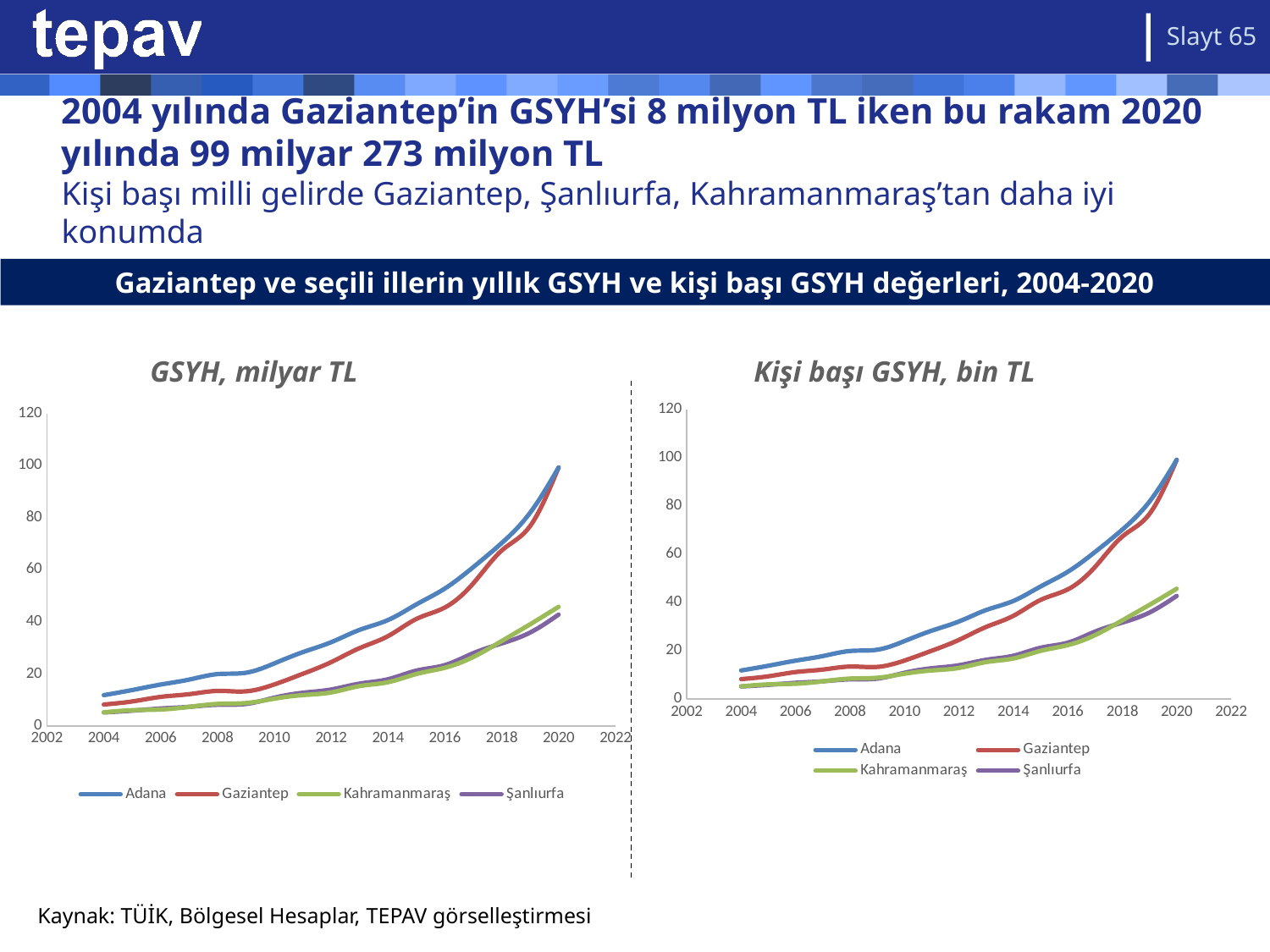
What is the title of the right chart on the slide? Kişi başı GSYH, bin TL How many series does the legend of the right chart 'Kişi başı GSYH, bin TL' list? 4 In the left chart 'GSYH, milyar TL', is the value for Adana in 2004 greater or less than 20? less In the right chart 'Kişi başı GSYH, bin TL', does the Kahramanmaraş line rise or fall from 2004 to 2020? rise In the left chart 'GSYH, milyar TL', is the value for Kahramanmaraş in 2020 greater or less than 40? greater In the left chart 'GSYH, milyar TL', does the Adana line rise or fall from 2004 to 2020? rise In the left chart 'GSYH, milyar TL', which is larger in 2020: Adana or Kahramanmaraş? Adana In the left chart 'GSYH, milyar TL', is the value for Gaziantep in 2020 greater or less than 80? greater In the right chart 'Kişi başı GSYH, bin TL', which is larger in 2016: Gaziantep or Şanlıurfa? Gaziantep What kind of chart is the left chart titled 'GSYH, milyar TL'? line chart